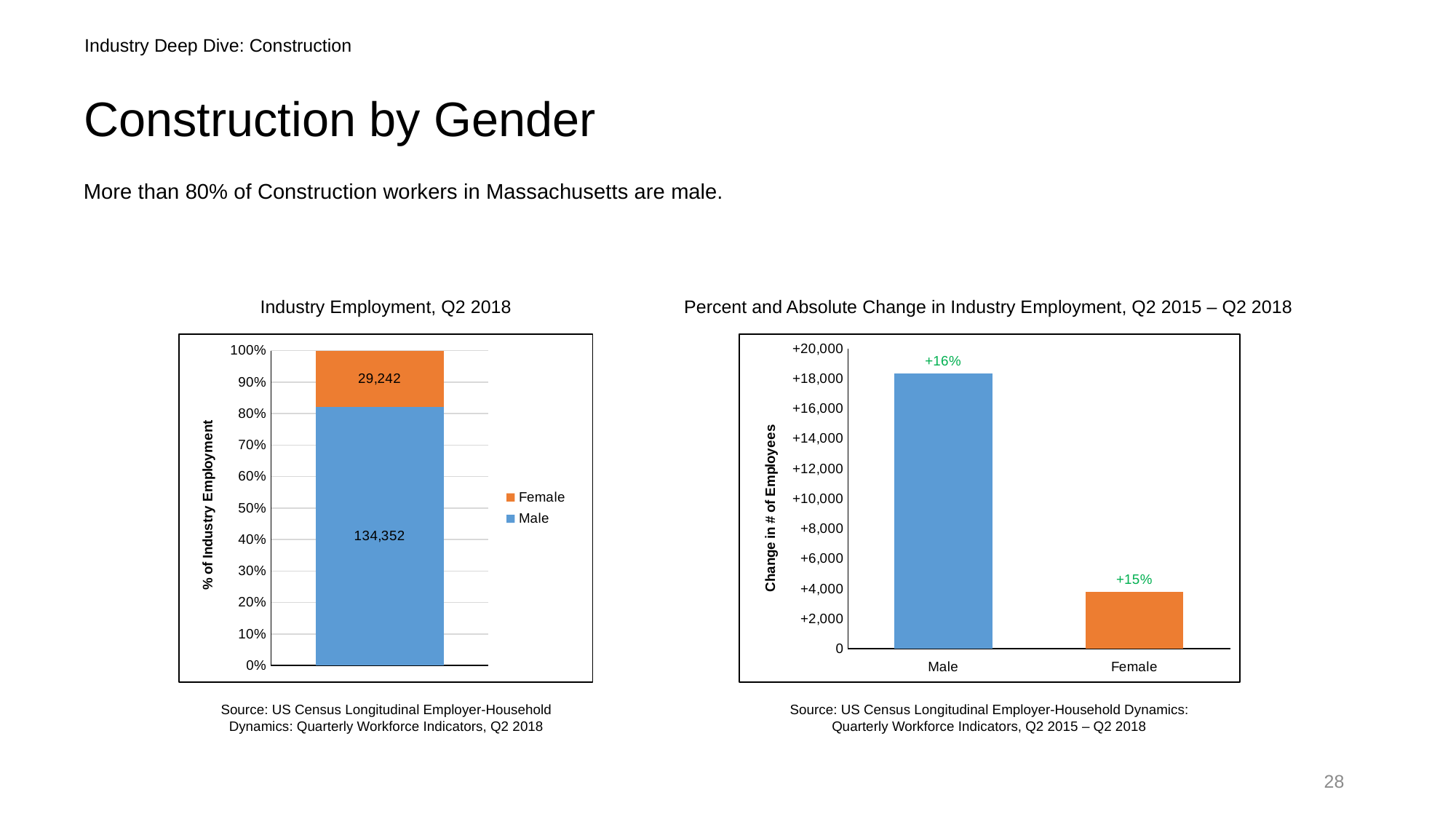
In the 'Percent and Absolute Change in Industry Employment, Q2 2015 – Q2 2018' chart, what percent change is shown for Female? +15% In the 'Industry Employment, Q2 2018' chart, which colour represents Female? Orange In the 'Industry Employment, Q2 2018' chart, what is the value shown for Female? 29,242 In the 'Percent and Absolute Change in Industry Employment, Q2 2015 – Q2 2018' chart, what percent change is shown for Male? +16% In the 'Percent and Absolute Change in Industry Employment, Q2 2015 – Q2 2018' chart, is the change in number of employees for Male greater or less than +16,000? greater What kind of chart is the 'Percent and Absolute Change in Industry Employment, Q2 2015 – Q2 2018' chart? Bar chart In the 'Percent and Absolute Change in Industry Employment, Q2 2015 – Q2 2018' chart, which category has the larger change in number of employees? Male In the 'Industry Employment, Q2 2018' chart, what is the total of the stacked bar? 163,594 In the 'Industry Employment, Q2 2018' chart, what is the difference between the Male and Female values? 105,110 In the 'Industry Employment, Q2 2018' chart, what is the value shown for Male? 134,352 In the 'Industry Employment, Q2 2018' chart, how many series does the legend list? 2